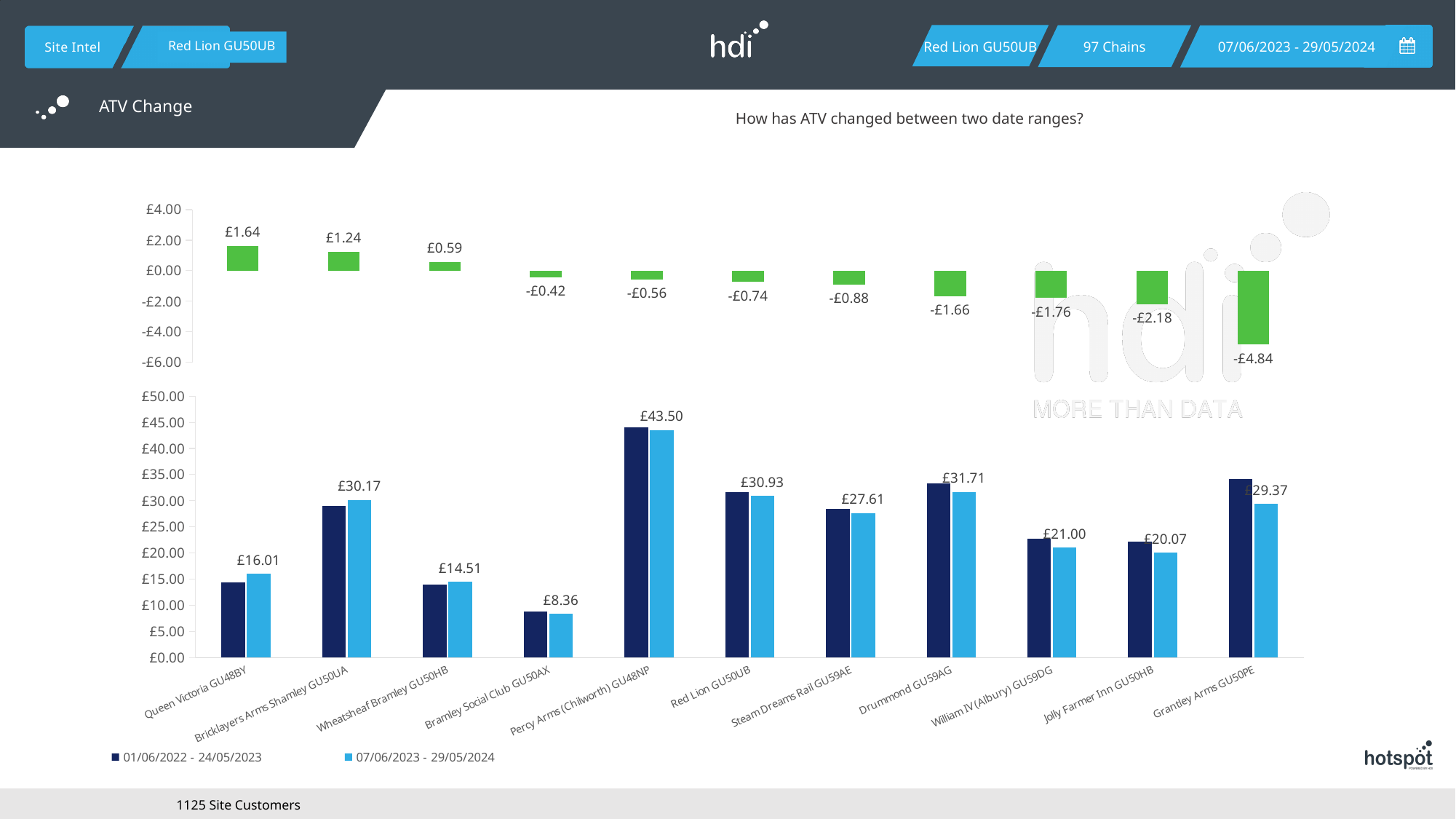
In the bottom chart, is the 01/06/2022 - 24/05/2023 value for Percy Arms (Chilworth) GU48NP greater or less than £40.00? greater In the top chart (ATV change), what is the value for Jolly Farmer Inn GU50HB? -£2.18 In the top chart (ATV change), how many sites are plotted? 11 In the bottom chart, which labelled value is larger: Drummond GU59AG or Red Lion GU50UB? Drummond GU59AG In the top chart (ATV change), what is the value for Queen Victoria GU48BY? £1.64 In the top chart (ATV change), which site has the highest value? Queen Victoria GU48BY What kind of chart is the bottom chart? bar chart In the bottom chart, what is the labelled value for Percy Arms (Chilworth) GU48NP? £43.50 In the bottom chart, what is the difference between the labelled values for Percy Arms (Chilworth) GU48NP and Red Lion GU50UB? £12.57 In the bottom chart, how many series does the legend list? 2 In the top chart (ATV change), which site has the lowest value? Grantley Arms GU50PE In the bottom chart, which site has the lowest labelled value? Bramley Social Club GU50AX